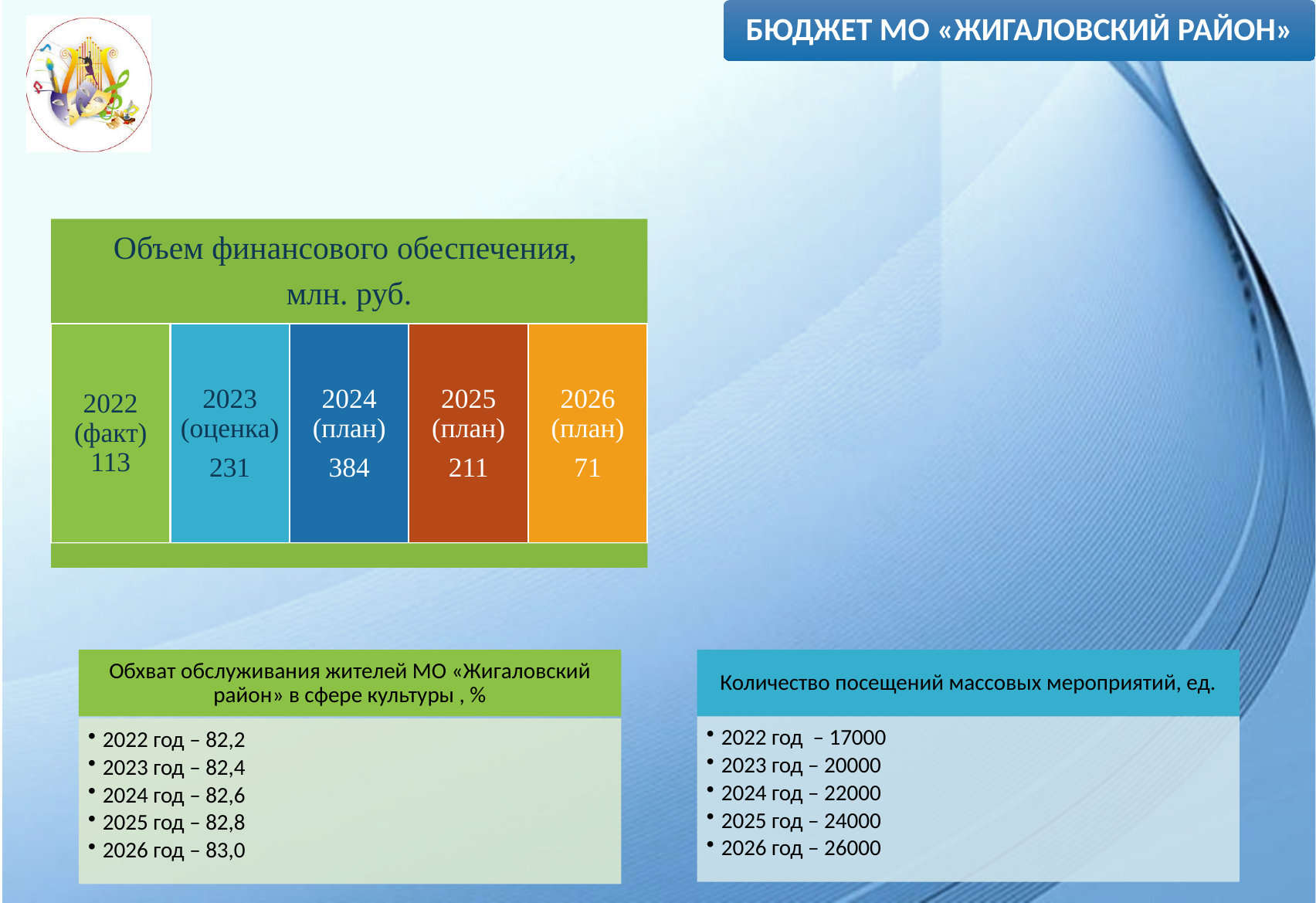
In the 'Объем финансового обеспечения, млн. руб.' chart, what is the value for 2024 (план)? 384 In the 'Объем финансового обеспечения, млн. руб.' chart, what is the value for 2022 (факт)? 113 In the 'Объем финансового обеспечения, млн. руб.' chart, what is the difference between the 2023 (оценка) and 2022 (факт) values? 118 In the 'Объем финансового обеспечения, млн. руб.' chart, which is larger: the value for 2023 (оценка) or 2025 (план)? 2023 (оценка) What unit is given in the title of the 'Объем финансового обеспечения' chart? млн. руб. How many years are shown in the 'Объем финансового обеспечения, млн. руб.' chart? 5 In the 'Объем финансового обеспечения, млн. руб.' chart, do the values rise or fall from 2024 (план) to 2026 (план)? fall In the 'Объем финансового обеспечения, млн. руб.' chart, which year has the lowest value? 2026 (план) In the 'Объем финансового обеспечения, млн. руб.' chart, what is the value for 2026 (план)? 71 In the 'Объем финансового обеспечения, млн. руб.' chart, what is the difference between the 2024 (план) and 2025 (план) values? 173 In the 'Объем финансового обеспечения, млн. руб.' chart, which year has the highest value? 2024 (план) In the 'Объем финансового обеспечения, млн. руб.' chart, what colour is the 2024 (план) block? blue